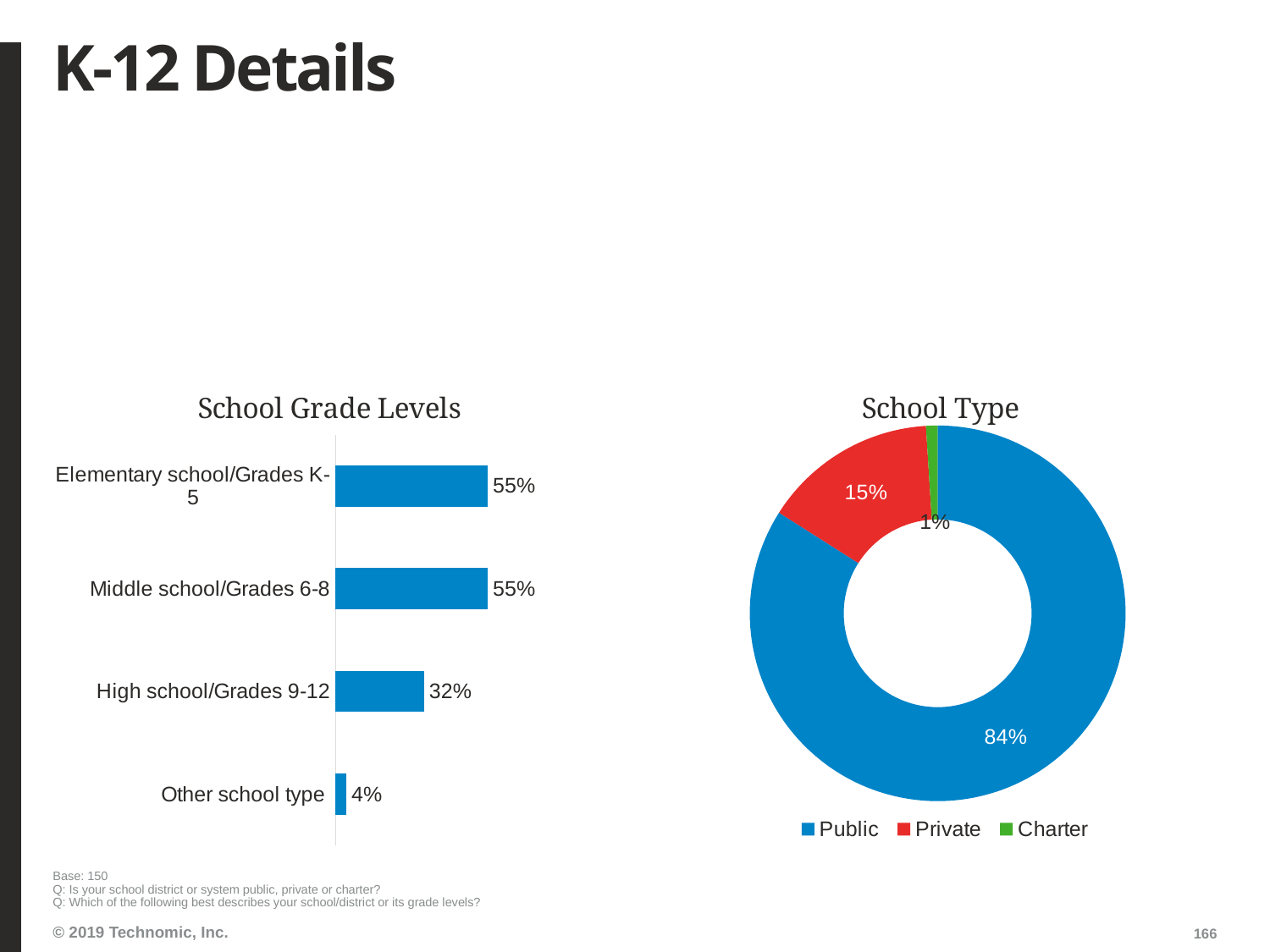
In the School Grade Levels chart, which category has the lowest value? Other school type What kind of chart is the School Grade Levels chart? Bar chart In the School Grade Levels chart, what is the value for High school/Grades 9-12? 32% In the School Grade Levels chart, what is the difference between Middle school/Grades 6-8 and High school/Grades 9-12? 23% In the School Grade Levels chart, which is larger: High school/Grades 9-12 or Other school type? High school/Grades 9-12 In the School Grade Levels chart, what is the value for Middle school/Grades 6-8? 55% How many entries does the legend of the School Type chart list? 3 In the School Type chart, which category has the largest share? Public In the School Type chart, what share is Public? 84% In the School Grade Levels chart, what is the value for Other school type? 4% How many categories are shown in the School Grade Levels chart? 4 In the School Type chart, what share is Private? 15%